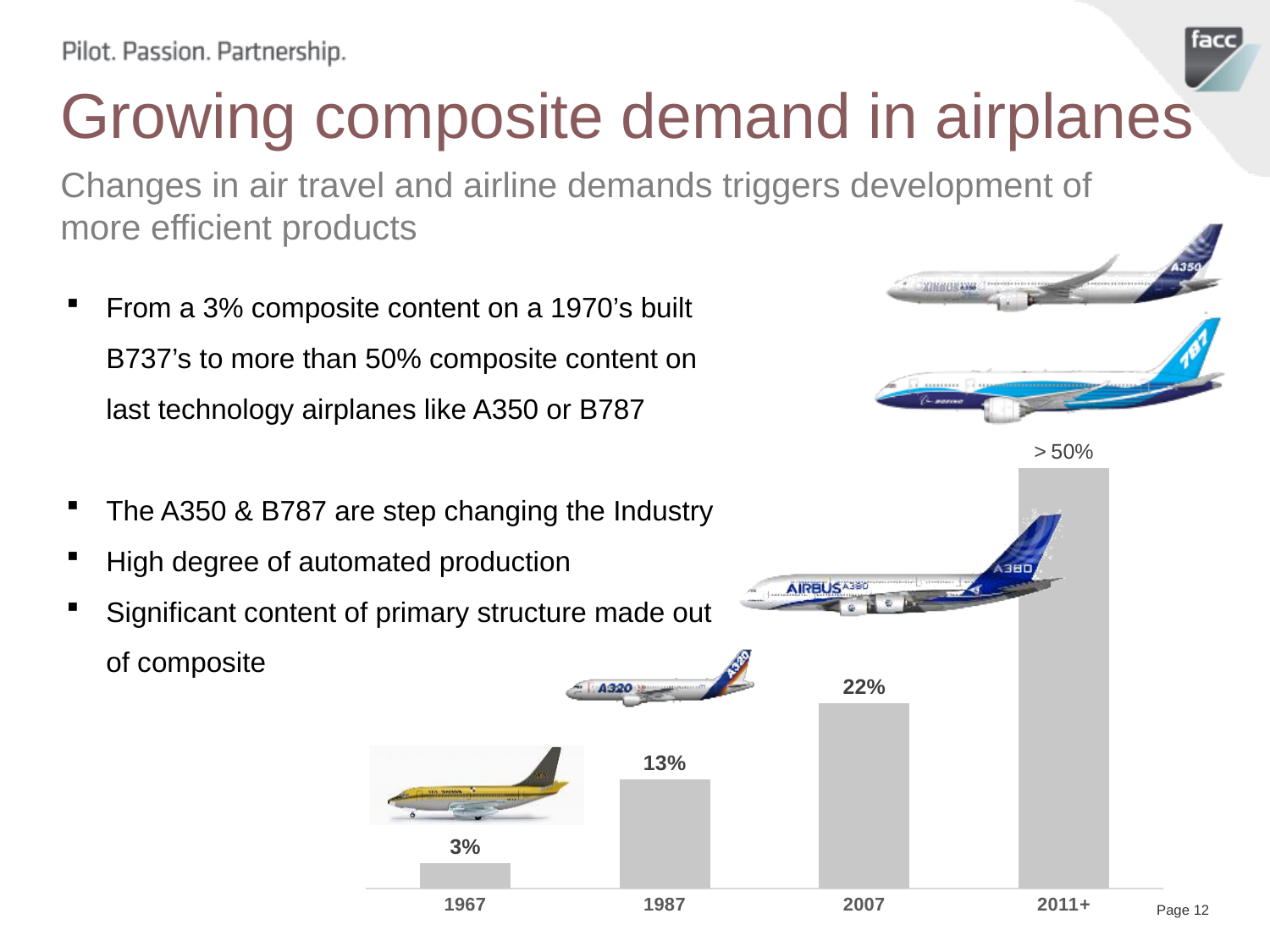
What label is shown above the bar for 2011+? > 50% Which category has the shortest bar? 1967 How many categories are shown on the x axis of the chart? 4 What is the difference between the values for 2007 and 1987? 9% What composite content value is shown for 2007? 22% Which is larger, the value for 2007 or the value for 1987? 2007 What is the difference between the values for 1987 and 1967? 10% Do the bar values rise or fall from 1967 to 2011+? Rise Which category has the tallest bar? 2011+ What composite content value is shown for 1987? 13% What kind of chart is shown on the slide? Bar chart What composite content value is shown for 1967? 3%